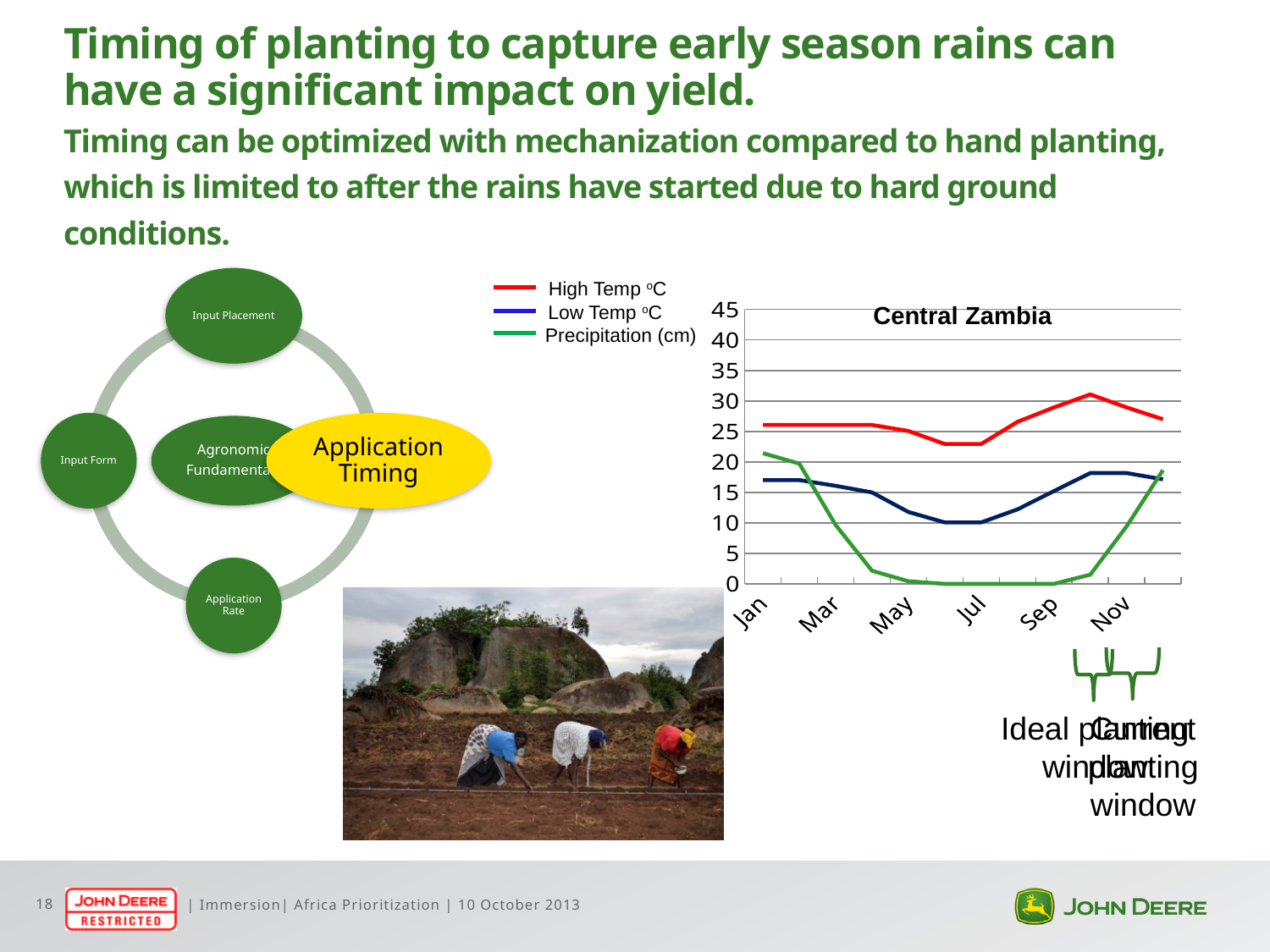
In the Central Zambia chart, which is larger in Jan: High Temp or Precipitation? High Temp In the Central Zambia chart, is the Precipitation value for Jan greater or less than 15? greater In the Central Zambia chart, which series reaches the highest value on the chart? High Temp In the Central Zambia chart, is the High Temp value for Nov greater or less than 25? greater In the Central Zambia chart, is the Precipitation value for Jul greater or less than 5? less In the Central Zambia chart, what colour is the Precipitation (cm) line? green How many series does the legend of the Central Zambia chart list? 3 In the Central Zambia chart, does Precipitation rise or fall from Jan to Jul? fall In the Central Zambia chart, which series has the lowest value in Jul? Precipitation What kind of chart is the Central Zambia chart? line chart What is the title of the chart on the slide? Central Zambia